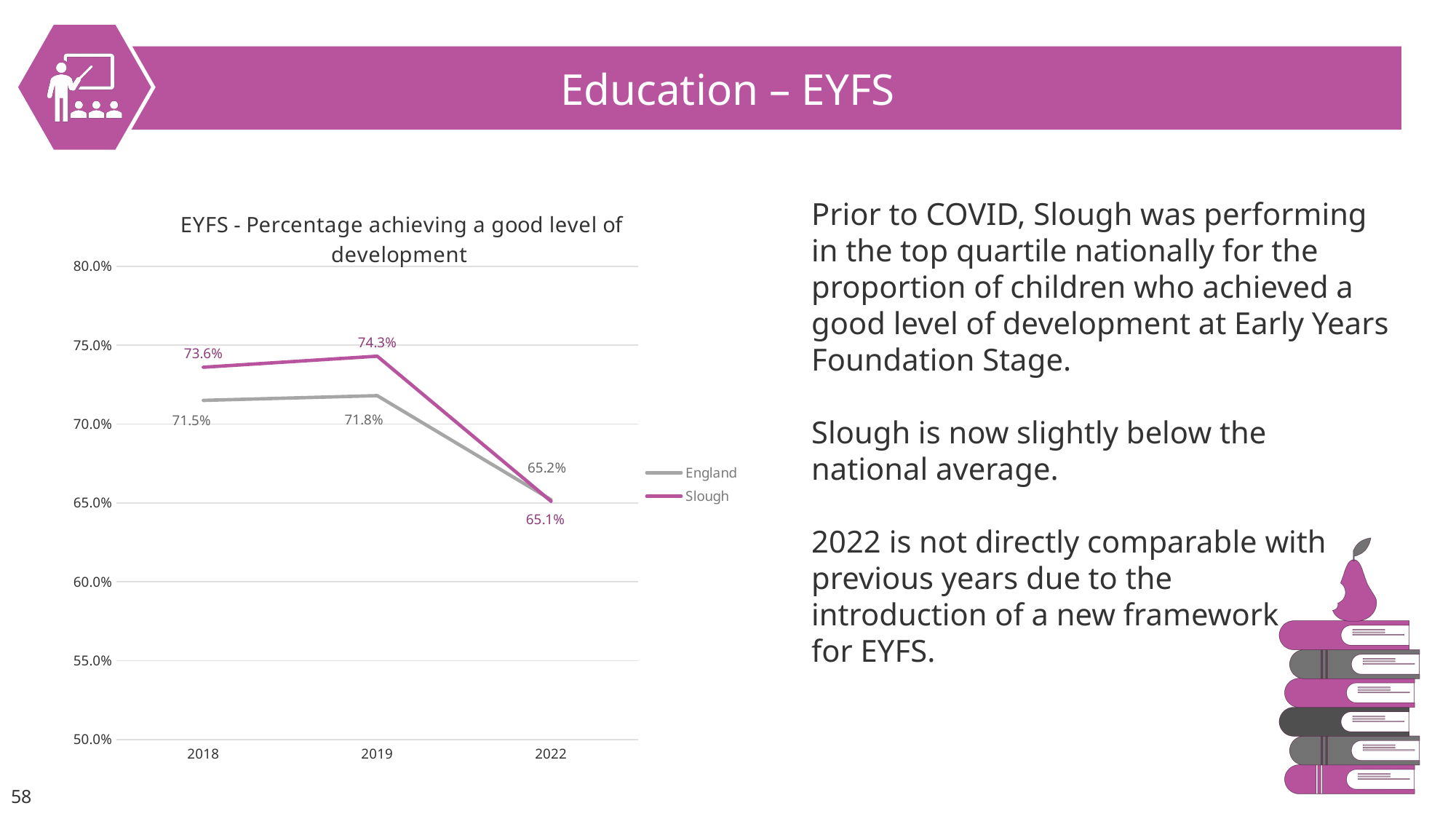
Which was higher in 2018, Slough or England? Slough What kind of chart is shown on the slide? Line chart In which year was Slough's percentage highest? 2019 How many series does the legend list? 2 In which year was England's percentage lowest? 2022 What is the difference between Slough's and England's values in 2019? 2.5% How many years are shown on the x axis? 3 What was Slough's percentage achieving a good level of development in 2019? 74.3% What was Slough's value in 2022? 65.1% What was England's percentage achieving a good level of development in 2018? 71.5% What was England's value in 2022? 65.2% Did Slough's percentage rise or fall between 2019 and 2022? Fall